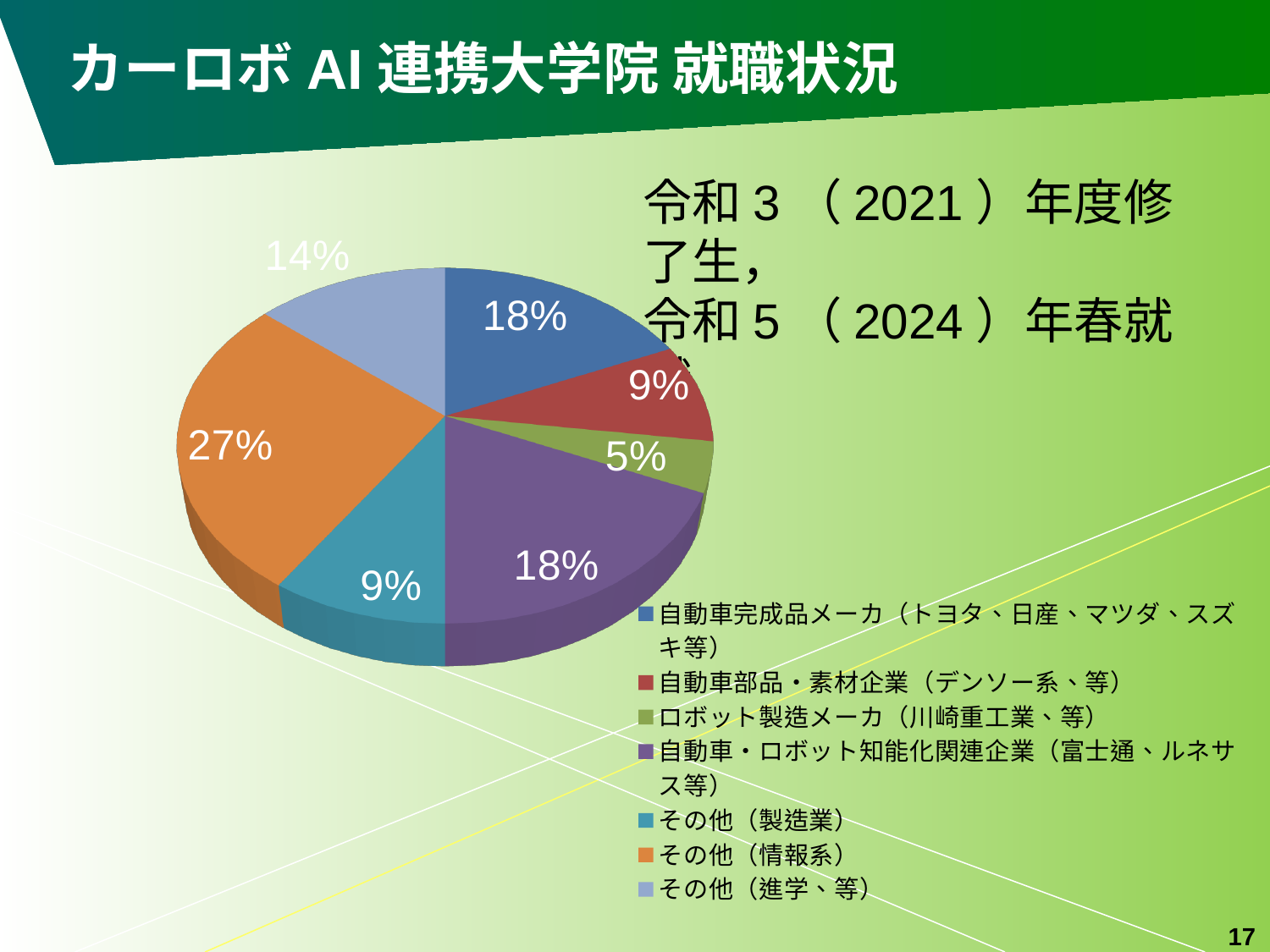
Which category has the smallest share of the pie? ロボット製造メーカ（川崎重工業、等） How many entries does the legend list? 7 What share of the pie is その他（情報系）? 27% What share of the pie is その他（進学、等）? 14% What share of the pie is ロボット製造メーカ（川崎重工業、等）? 5% What kind of chart is shown on the slide? pie chart Which is larger, the share for 自動車部品・素材企業（デンソー系、等） or the share for ロボット製造メーカ（川崎重工業、等）? 自動車部品・素材企業（デンソー系、等） What colour is the slice for その他（情報系）? orange Which category has the largest share of the pie? その他（情報系） How many slices does the pie chart have? 7 What is the difference in percentage points between その他（情報系） and その他（進学、等）? 13